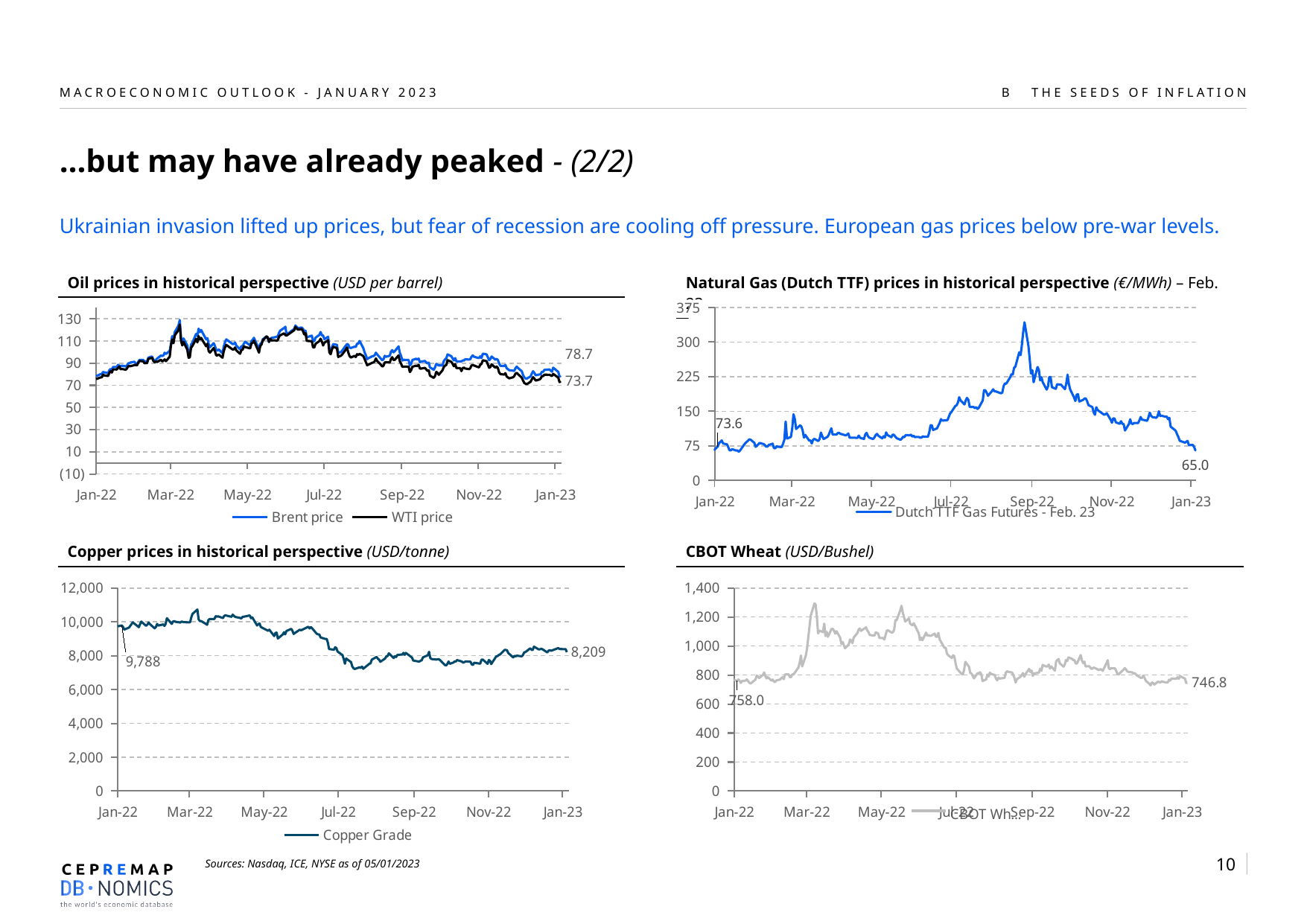
On the 'Natural Gas (Dutch TTF) prices in historical perspective' chart, what is the labelled value at the start of the series in Jan-22? 73.6 On the 'Copper prices in historical perspective' chart, what is the labelled value at the start of the series? 9,788 What kind of chart is the 'CBOT Wheat' chart? line chart On the 'Natural Gas (Dutch TTF) prices in historical perspective' chart, do values rise or fall between Sep-22 and Jan-23? fall How many series does the legend of the 'Oil prices in historical perspective' chart list? 2 On the 'Oil prices in historical perspective' chart, what is the latest labelled value for the WTI price? 73.7 On the 'Natural Gas (Dutch TTF) prices in historical perspective' chart, what is the labelled value at the end of the series in Jan-23? 65.0 On the 'Oil prices in historical perspective' chart, what is the latest labelled value for the Brent price? 78.7 On the 'Oil prices in historical perspective' chart, what is the difference between the labelled end values of Brent price and WTI price? 5.0 On the 'Copper prices in historical perspective' chart, what is the difference between the labelled start value and the labelled end value? 1,579 On the 'CBOT Wheat' chart, what is the labelled value at the end of the series in Jan-23? 746.8 On the 'Natural Gas (Dutch TTF) prices in historical perspective' chart, is the peak value reached around Aug/Sep-22 greater or less than 300? greater